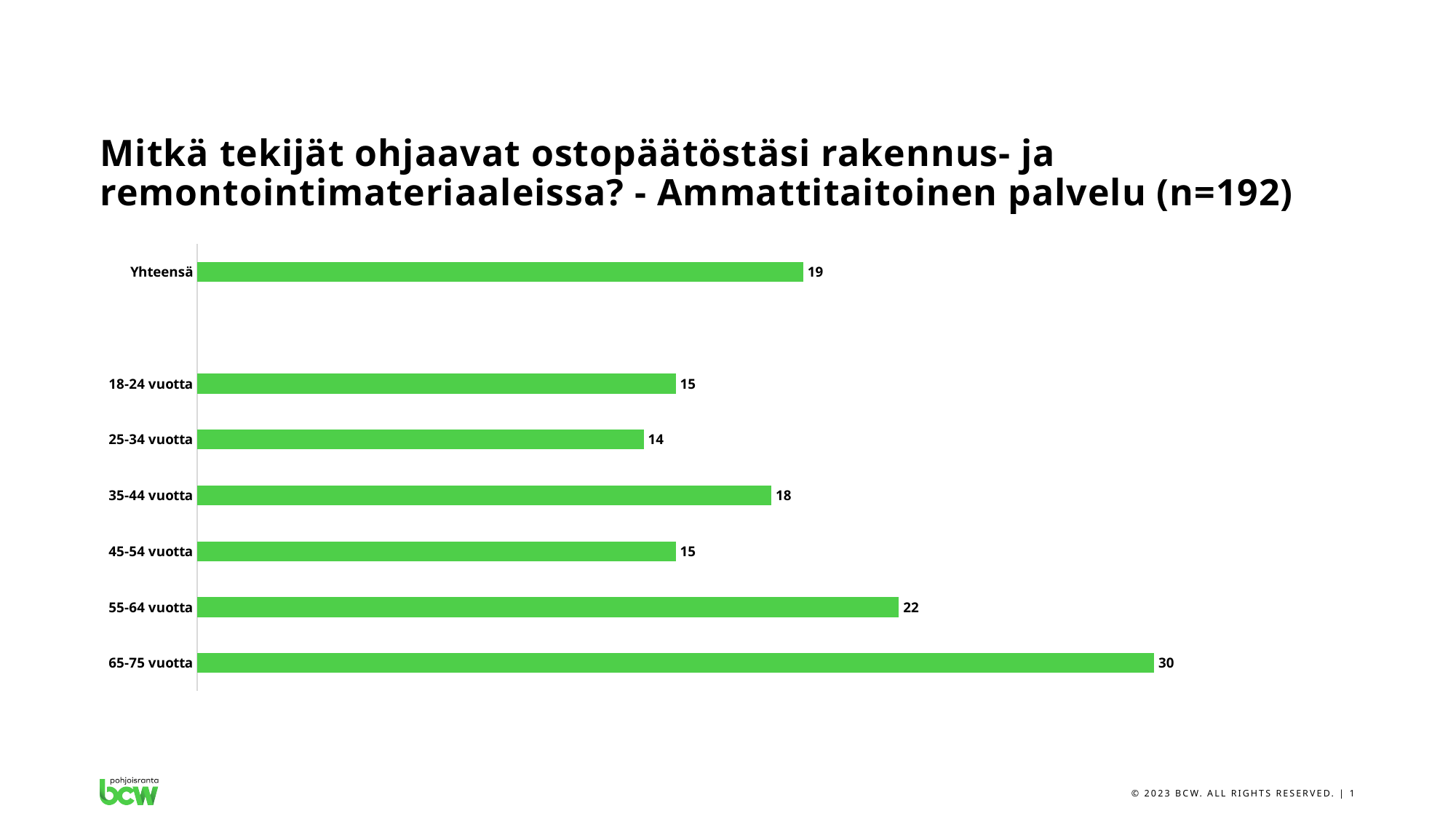
What colour are the bars in the chart? Green How many categories are shown in the chart? 7 What is the difference between the values for 35-44 vuotta and 25-34 vuotta? 4 What kind of chart is shown on the slide? Bar chart Which is larger, the value for 35-44 vuotta or the value for 45-54 vuotta? 35-44 vuotta What is the value for 55-64 vuotta? 22 What is the value for Yhteensä? 19 Which age group has the highest value? 65-75 vuotta What is the difference between the values for 65-75 vuotta and 55-64 vuotta? 8 What is the value for 25-34 vuotta? 14 Which age group has the lowest value? 25-34 vuotta What is the value for 65-75 vuotta? 30